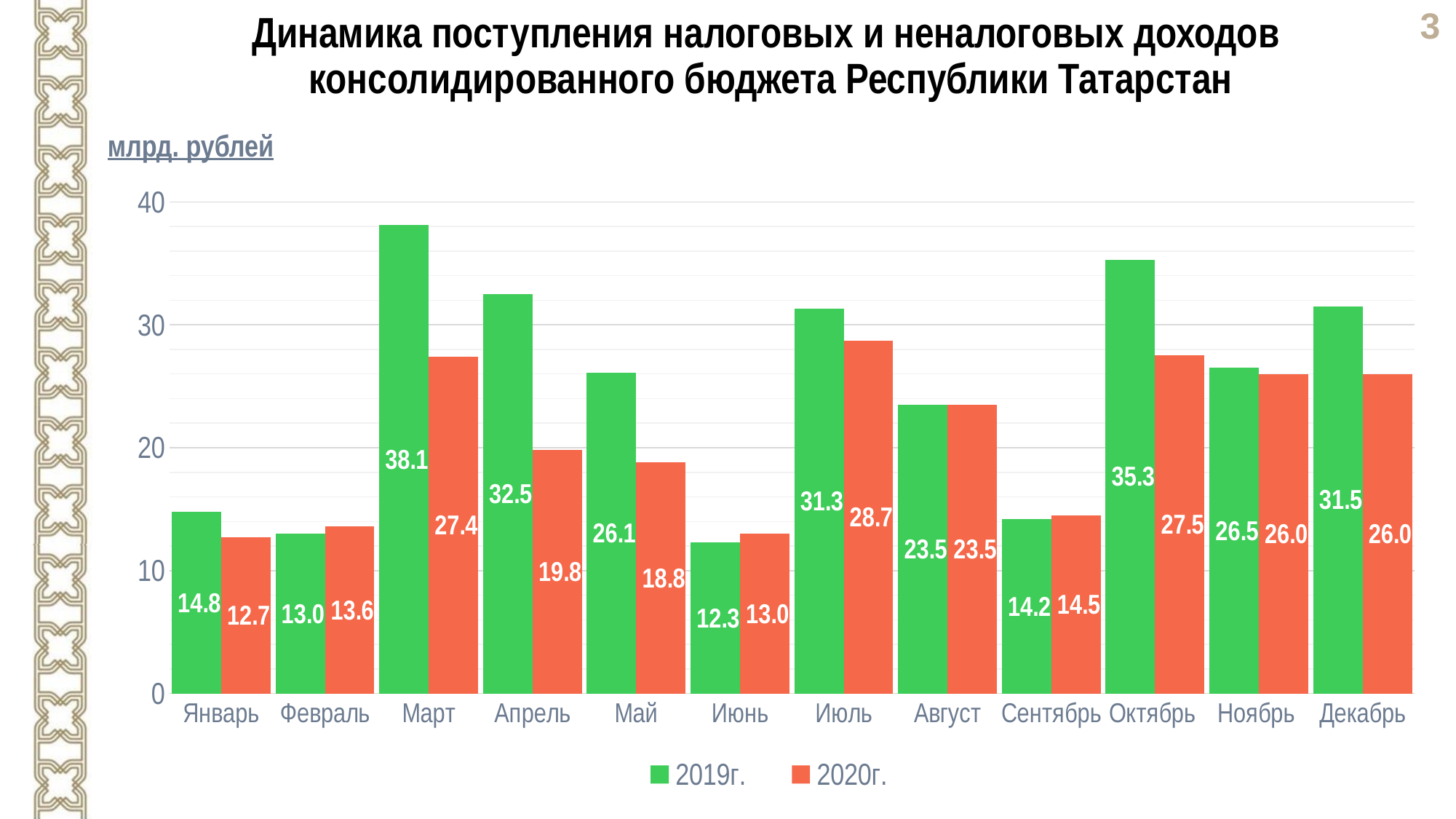
What is the value for 2020г. in Июль? 28.7 How many series does the legend list? 2 What unit is stated above the chart? млрд. рублей How many months are shown on the x axis? 12 What is the difference between the 2019г. values for Март and Июнь? 25.8 What kind of chart is shown on the slide? bar chart Which month has the lowest value for 2020г.? Январь What is the value for 2019г. in Март? 38.1 Which month has the highest value for 2019г.? Март Is the value for 2019г. in Октябрь greater or less than 30? greater Which is larger in Февраль: the 2019г. value or the 2020г. value? 2020г. What is the difference between the 2019г. and 2020г. values in Апрель? 12.7